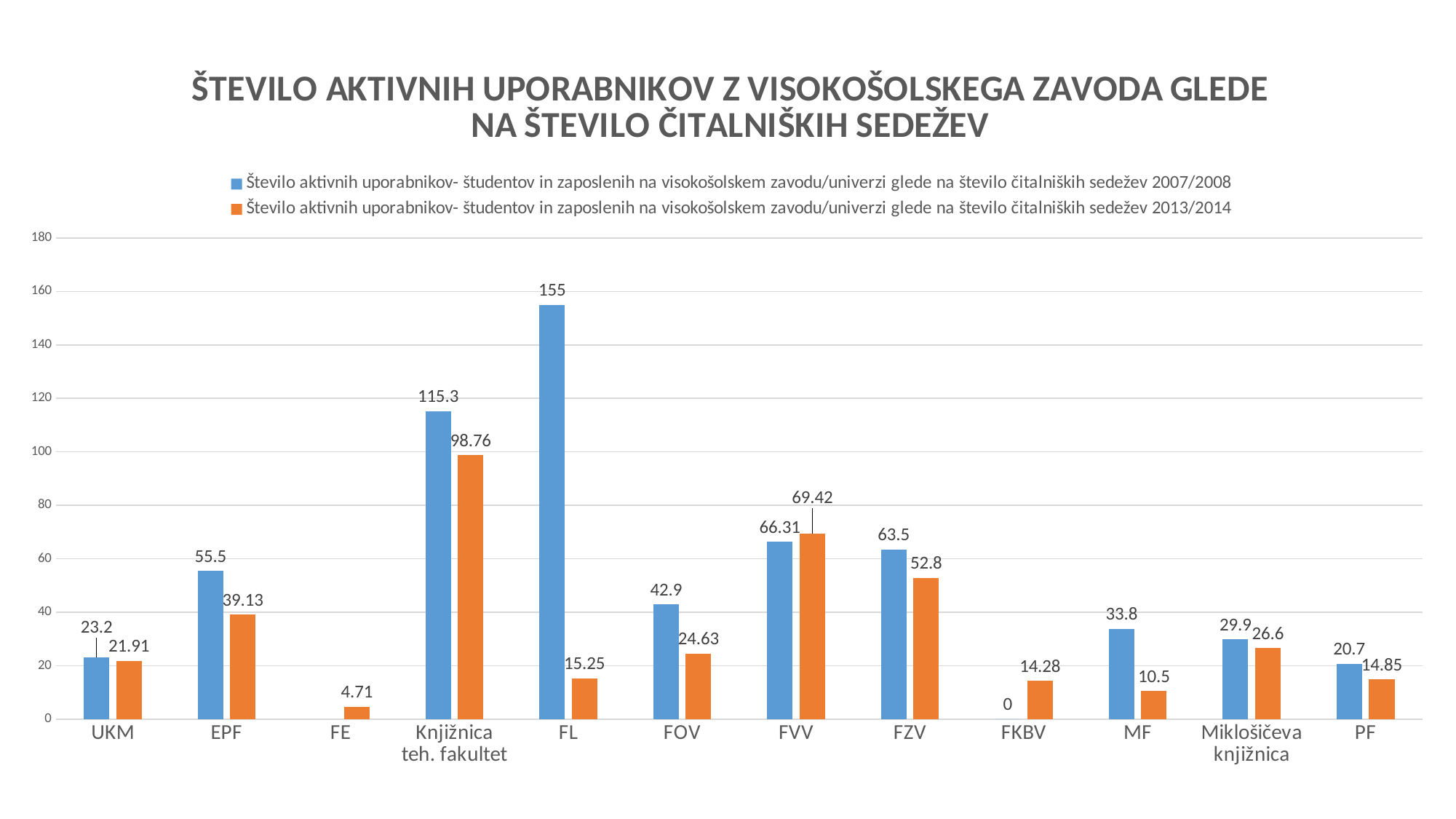
What is the value for FKBV in the 2007/2008 series? 0 What is the value for FL in the 2007/2008 series? 155 What is the value for Knjižnica teh. fakultet in the 2013/2014 series? 98.76 How many categories are shown on the x axis? 12 Which category has the highest value in the 2013/2014 series? Knjižnica teh. fakultet What is the difference between the 2007/2008 and 2013/2014 values for EPF? 16.37 How many series does the legend list? 2 What is the difference between the 2007/2008 and 2013/2014 values for FL? 139.75 What is the value for MF in the 2013/2014 series? 10.5 Which category has the lowest value in the 2013/2014 series? FE Which category has the highest value in the 2007/2008 series? FL For FVV, which series has the larger value, 2007/2008 or 2013/2014? 2013/2014